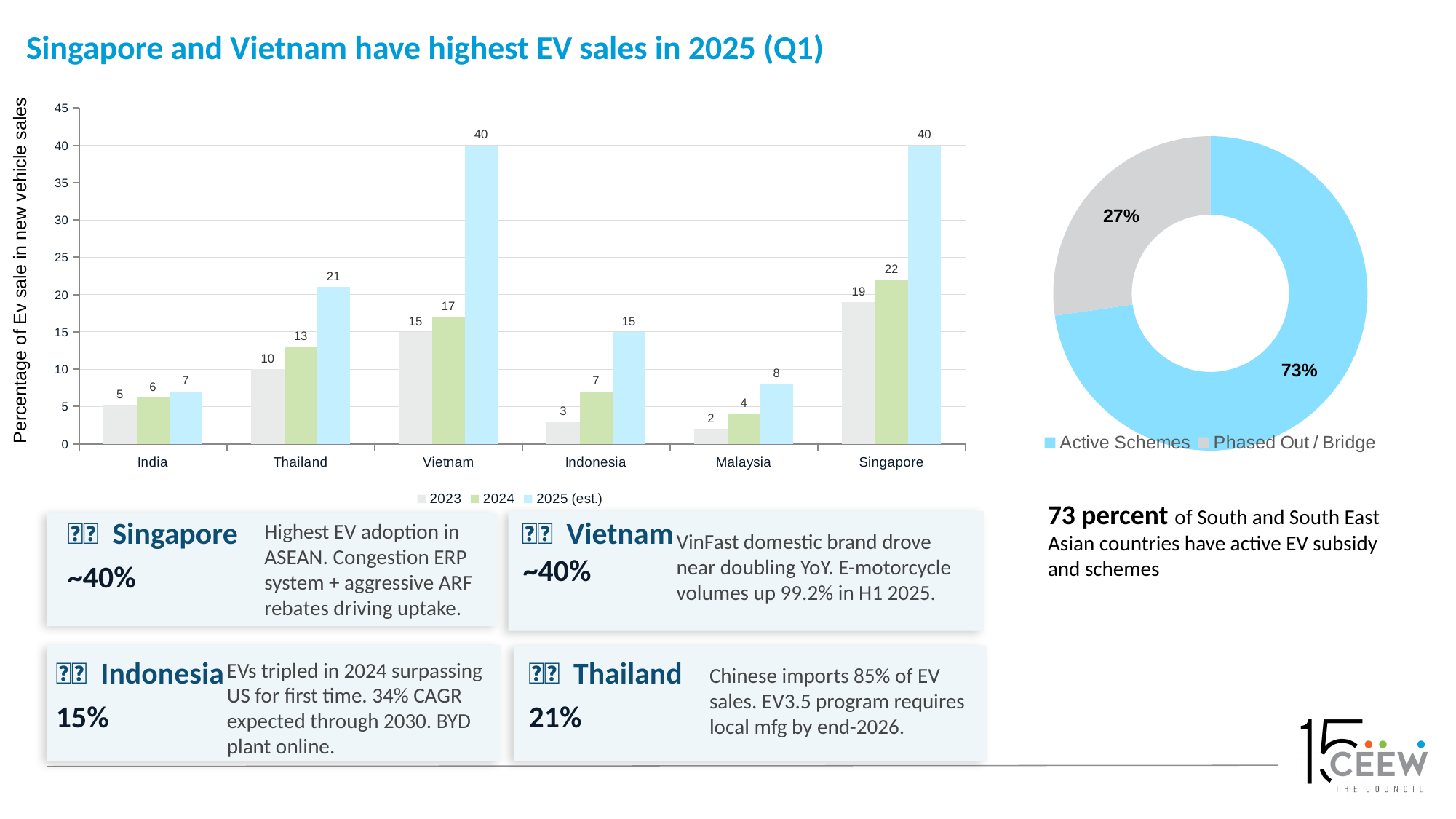
In the bar chart on the left, what is the 2025 (est.) value for Thailand? 21 In the bar chart on the left, which country has the highest 2024 value? Singapore In the bar chart on the left, how many series does the legend list? 3 In the bar chart on the left, how many countries are shown on the x axis? 6 In the bar chart on the left, do the values for Indonesia rise or fall from 2023 to 2025 (est.)? rise In the bar chart on the left, is the 2024 value for Thailand or the 2024 value for Vietnam larger? Vietnam In the donut chart on the right, what share is labelled for Active Schemes? 73% In the bar chart on the left, what is the 2023 value for Singapore? 19 In the bar chart on the left, what is the difference between the 2025 (est.) and 2024 values for Vietnam? 23 In the bar chart on the left, which country has the lowest 2023 value? Malaysia What kind of chart is the chart on the right of the slide? donut chart In the bar chart on the left, what is the 2024 value for Indonesia? 7